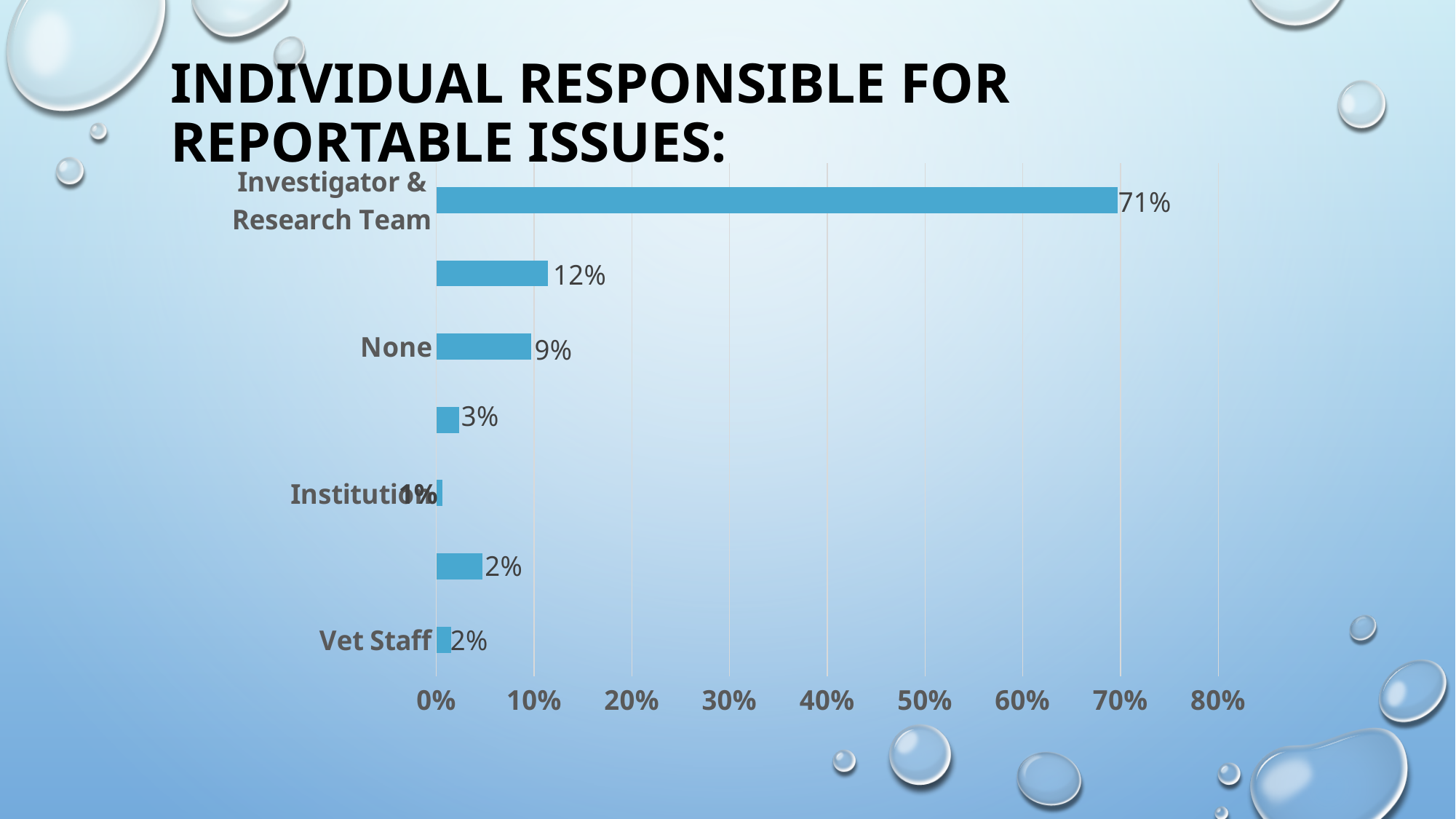
What is the value for Investigator & Research Team? 71% What is the value for Institution? 1% What is the value for None? 9% Which category has the highest value? Investigator & Research Team What is the value for Vet Staff? 2% What is the title of the slide? Individual Responsible for Reportable Issues: How many bars are plotted in the chart? 7 Which category has the lowest value? Institution Which is larger, the value for None or the value for Vet Staff? None What kind of chart is shown on the slide? Bar chart What is the difference between the values for Investigator & Research Team and None? 62 percentage points